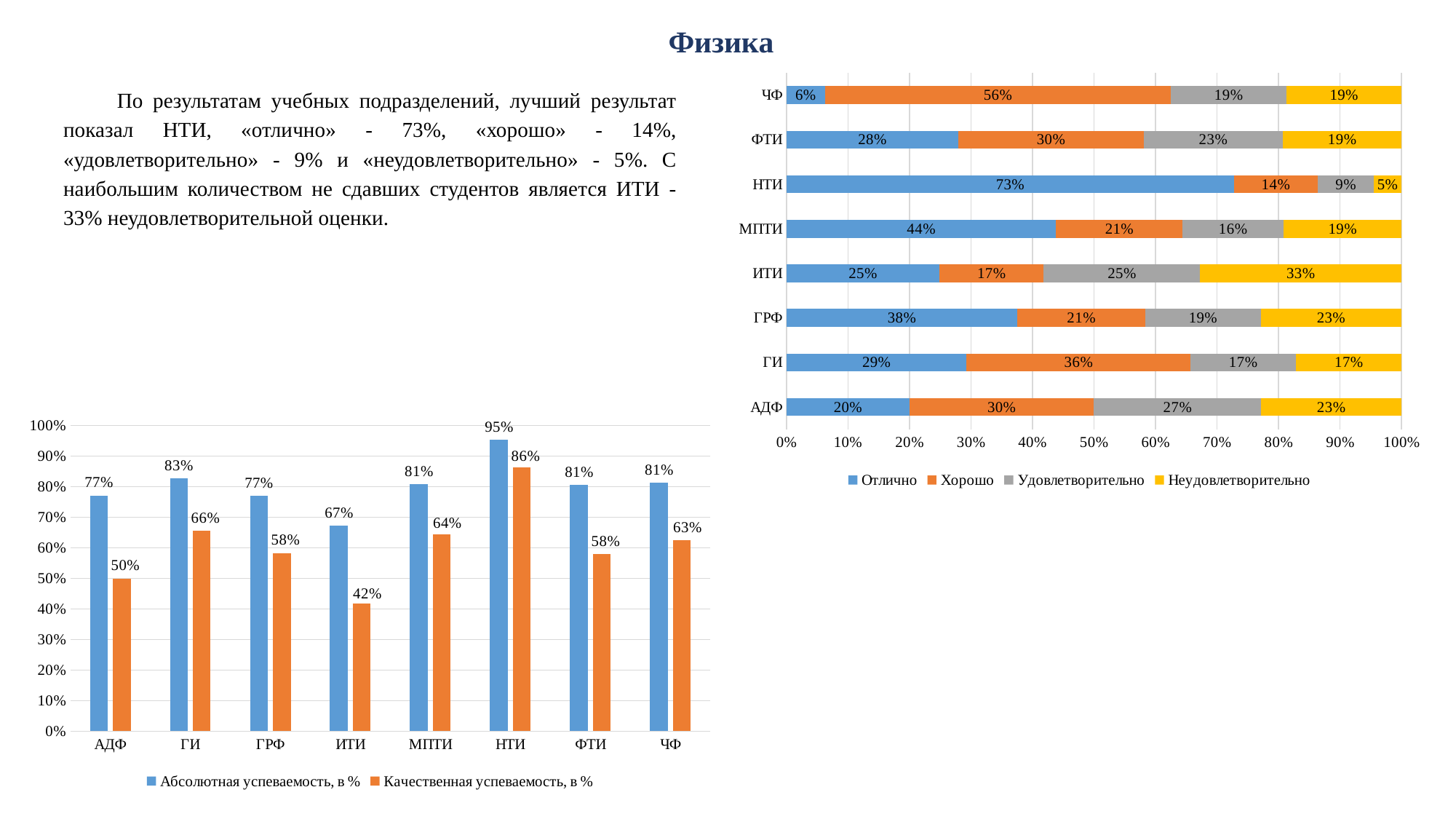
In the bar chart at the bottom left, how many series does the legend list? 2 In the stacked bar chart on the right, which category has the highest Отлично share? НТИ In the bar chart at the bottom left, how many categories are shown on the x axis? 8 In the stacked bar chart on the right, which is larger: the Хорошо share for ЧФ or for ГИ? ЧФ What type of chart is shown on the right of the slide? Stacked bar chart In the bar chart at the bottom left, what is the value of Качественная успеваемость for ИТИ? 42% In the bar chart at the bottom left, what is the value of Абсолютная успеваемость for НТИ? 95% In the stacked bar chart on the right, how many series does the legend list? 4 In the bar chart at the bottom left, what is the difference between Абсолютная успеваемость and Качественная успеваемость for АДФ? 27% In the stacked bar chart on the right, what is the Неудовлетворительно share for ИТИ? 33% In the bar chart at the bottom left, which category has the lowest Качественная успеваемость? ИТИ In the stacked bar chart on the right, what is the Отлично share for МПТИ? 44%